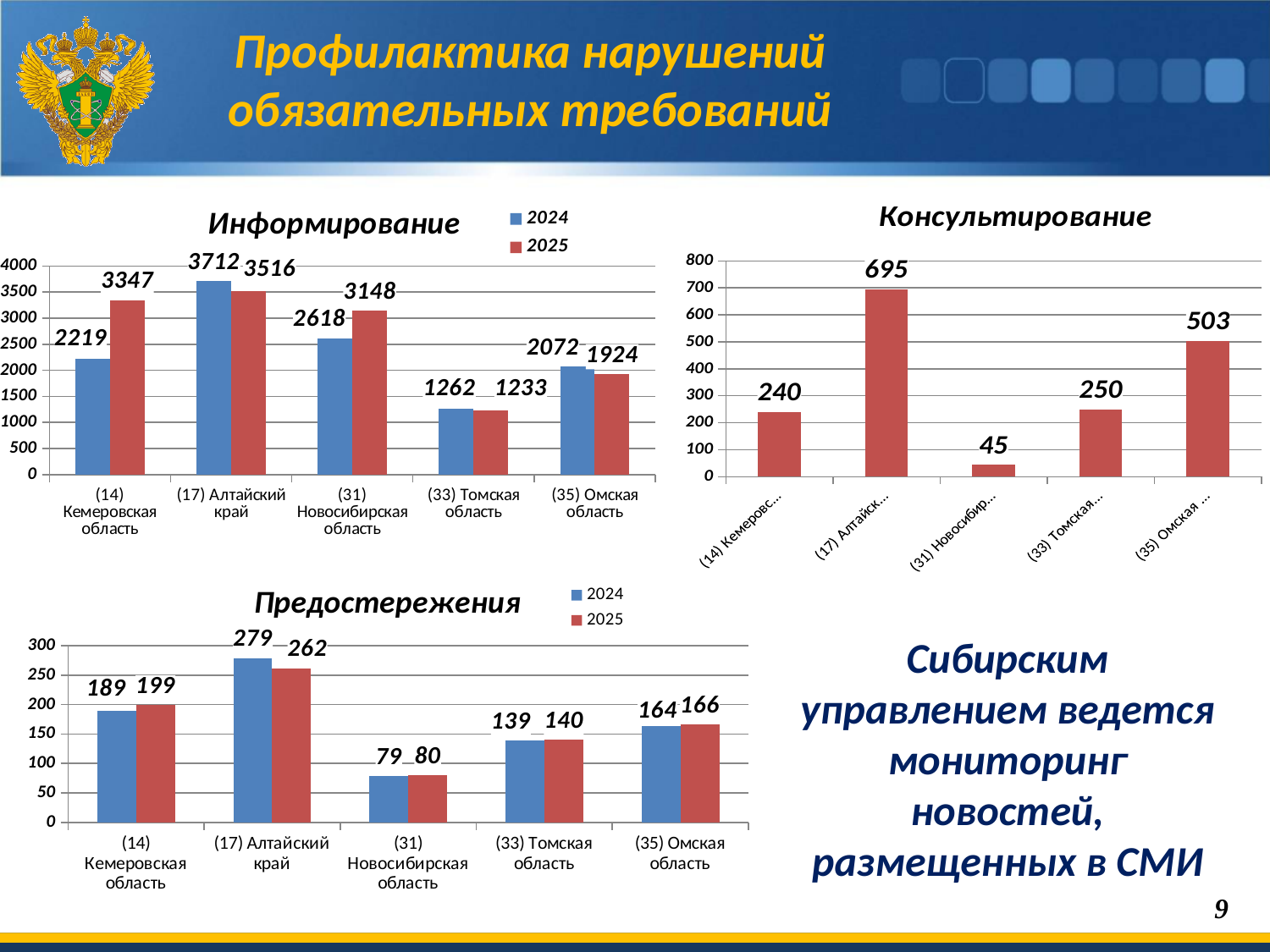
In the 'Консультирование' chart, how many regions are shown? 5 In the 'Консультирование' chart, what is the value for (17) Алтайский край? 695 In the 'Консультирование' chart, which region has the lowest value? (31) Новосибирская область In the 'Информирование' chart, what is the 2024 value for (17) Алтайский край? 3712 In the 'Информирование' chart, what is the 2025 value for (14) Кемеровская область? 3347 In the 'Информирование' chart, how many series does the legend list? 2 In the 'Предостережения' chart, which is larger for (14) Кемеровская область: the 2024 value or the 2025 value? 2025 In the 'Предостережения' chart, what is the 2024 value for (33) Томская область? 139 In the 'Информирование' chart, what is the difference between the 2025 and 2024 values for (31) Новосибирская область? 530 What type of chart is the 'Предостережения' chart? Bar chart In the 'Предостережения' chart, what is the difference between the 2024 and 2025 values for (17) Алтайский край? 17 In the 'Информирование' chart, which region has the highest 2025 value? (17) Алтайский край